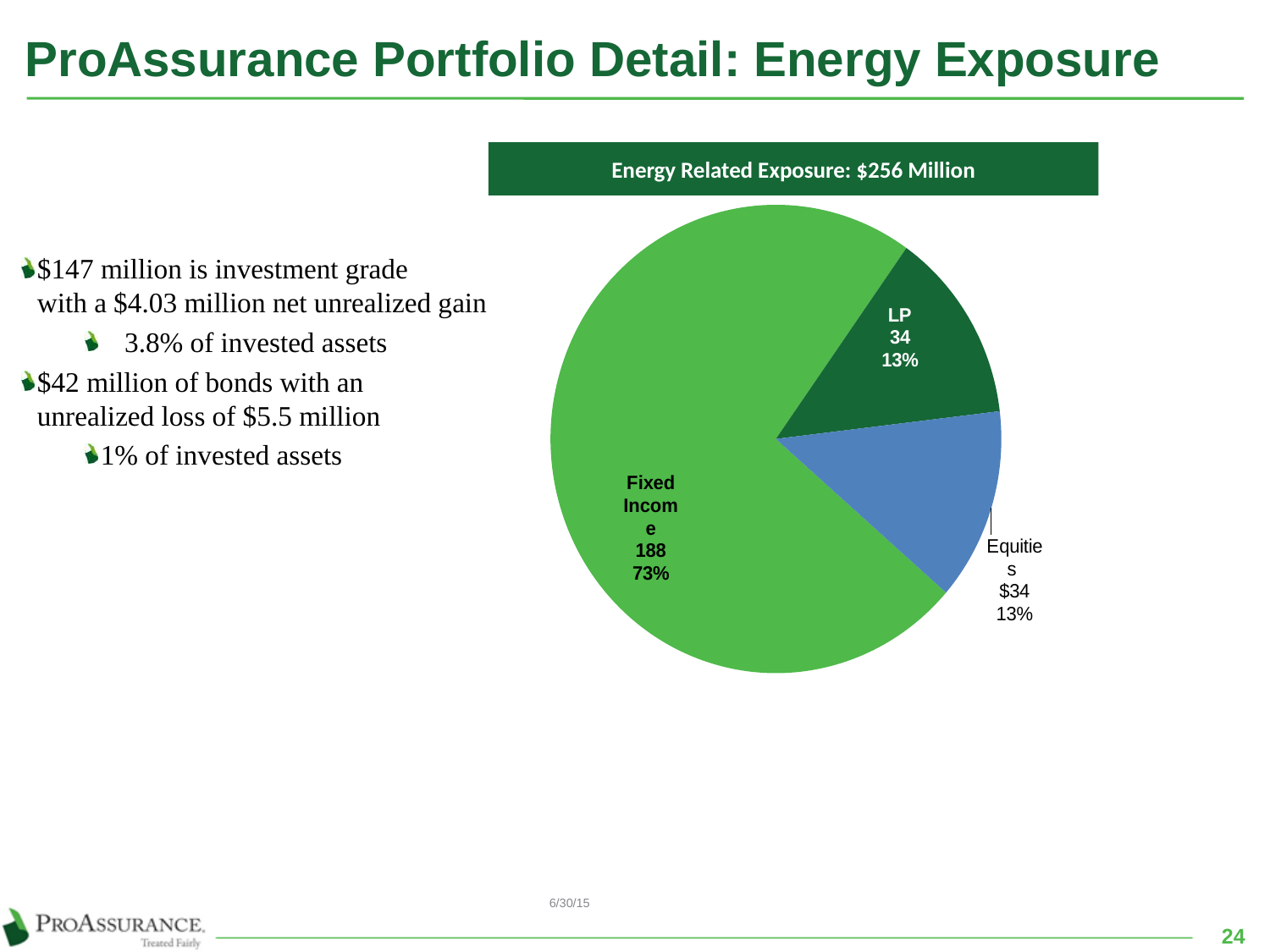
What is the difference between the Fixed Income value and the LP value? 154 What is the title of the chart? Energy Related Exposure: $256 Million What share of the pie does LP represent? 13% What share of the pie does Fixed Income represent? 73% What value is shown for the Fixed Income slice? 188 Which slice of the pie is the largest? Fixed Income Which is larger, the Fixed Income slice or the Equities slice? Fixed Income What share of the pie does Equities represent? 13% What kind of chart is shown on the slide? Pie chart What value is shown for the LP slice? 34 How many slices does the pie chart have? 3 What value is shown for the Equities slice? $34